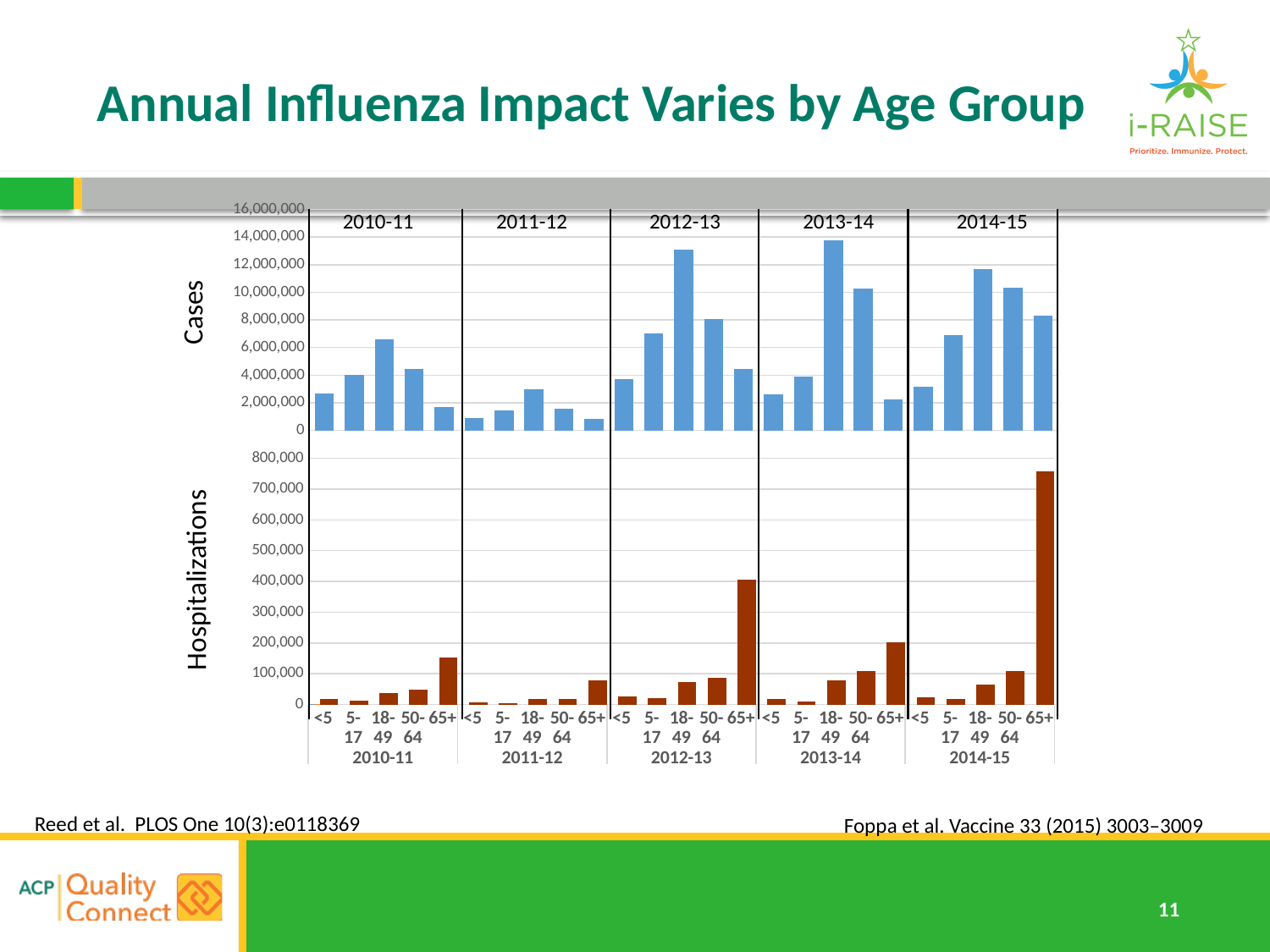
On the Cases chart, which age group has the highest number of cases in 2011-12? 18-49 On the Hospitalizations chart, is the value for 65+ in 2014-15 greater or less than 700,000? greater On the Hospitalizations chart, is the value for 65+ in 2012-13 greater or less than 300,000? greater How many influenza seasons are shown along the x axis of the Hospitalizations chart? 5 What is the y-axis label of the top chart on the slide? Cases How many age groups are plotted within each season on the Cases chart? 5 On the Hospitalizations chart, which age group and season has the highest bar? 65+ in 2014-15 On the Cases chart, is the value for 65+ in 2014-15 greater or less than 6,000,000? greater On the Hospitalizations chart, which season has the larger 65+ value: 2012-13 or 2013-14? 2012-13 What kind of chart is the Cases chart at the top of the slide? Bar chart On the Cases chart, which has more cases in 2010-11: the 18-49 group or the 65+ group? 18-49